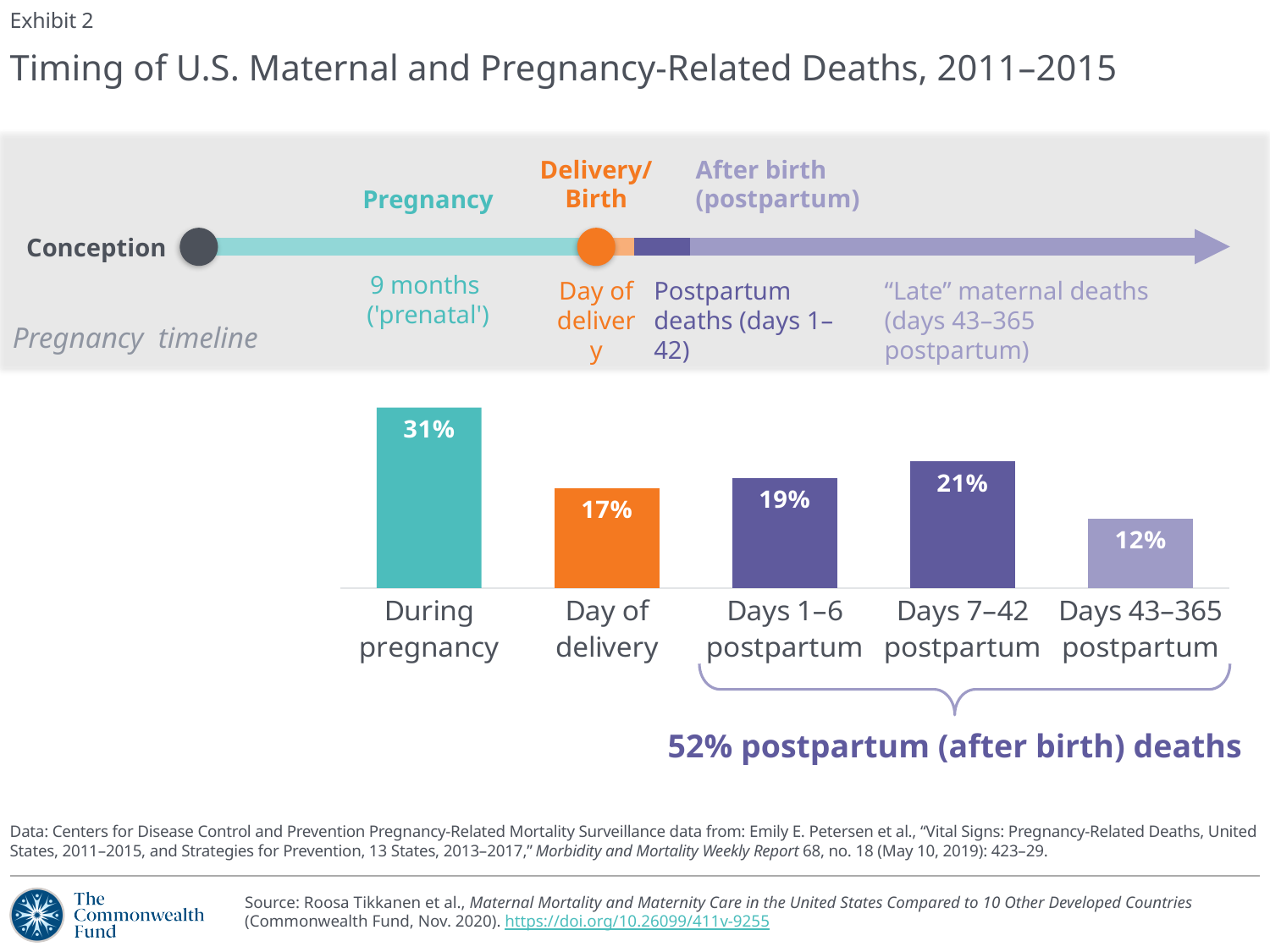
What is the value for Days 7–42 postpartum? 21% What type of chart is used to show the timing of deaths? Bar chart What is the title of the chart? Timing of U.S. Maternal and Pregnancy-Related Deaths, 2011–2015 What percentage of maternal and pregnancy-related deaths occurred during pregnancy? 31% Which is larger: the share of deaths in Days 1–6 postpartum or Days 7–42 postpartum? Days 7–42 postpartum Which timing category has the lowest share of deaths? Days 43–365 postpartum Which timing category has the highest share of deaths? During pregnancy How many timing categories are shown in the bar chart? 5 What is the combined share of postpartum (after birth) deaths, as annotated on the chart? 52% What is the value for Days 43–365 postpartum? 12% What percentage of deaths occurred on the day of delivery? 17% What is the difference between the share of deaths during pregnancy and on the day of delivery? 14%